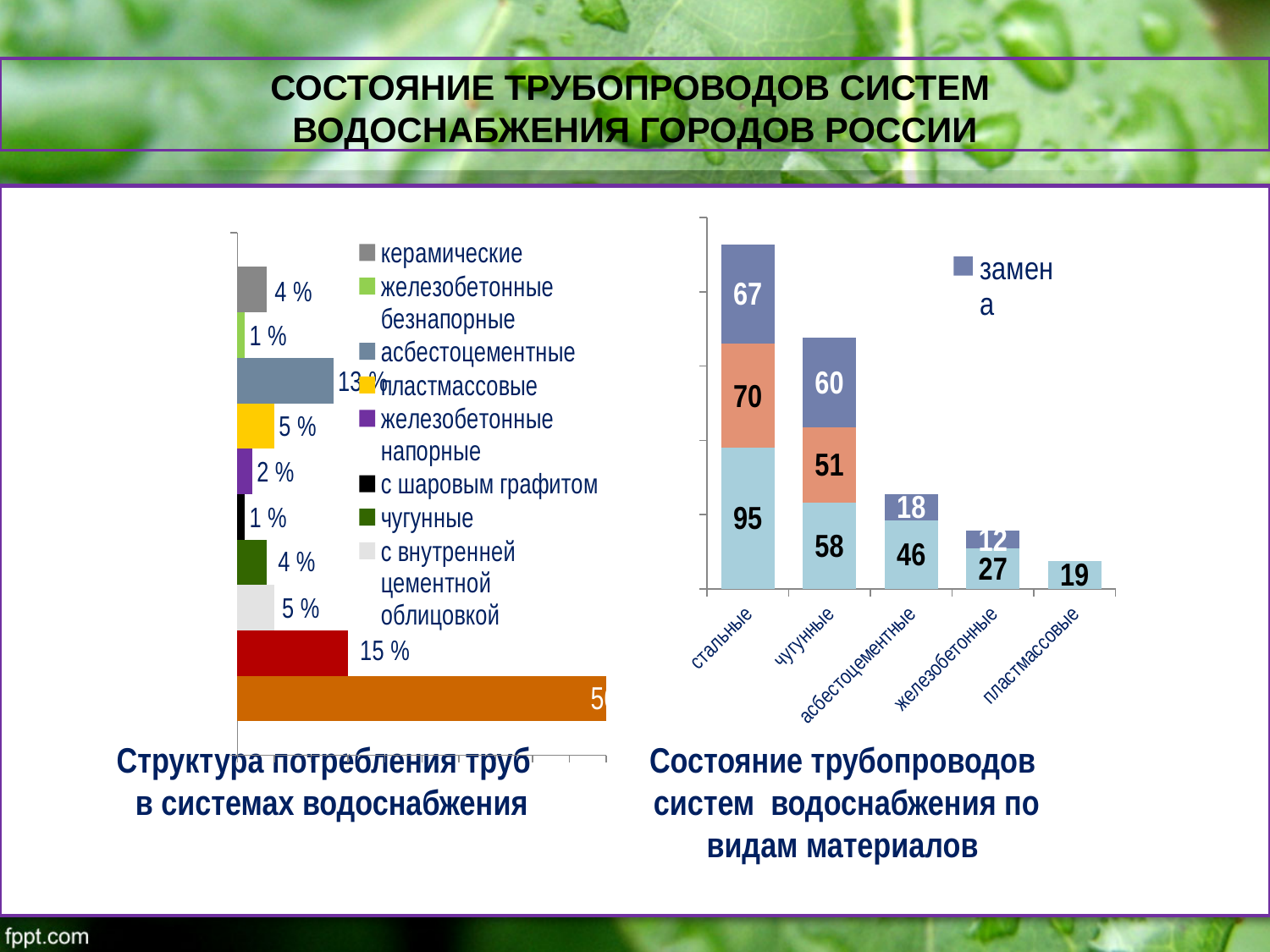
In the right chart 'Состояние трубопроводов систем водоснабжения по видам материалов', what is the value of the bottom segment for стальные? 95 How many categories are shown on the x axis of the right chart 'Состояние трубопроводов систем водоснабжения по видам материалов'? 5 In the right chart 'Состояние трубопроводов систем водоснабжения по видам материалов', what is the value of the top segment (замена) for чугунные? 60 In the right chart 'Состояние трубопроводов систем водоснабжения по видам материалов', what is the total of the stacked bar for чугунные? 169 In the left chart 'Структура потребления труб в системах водоснабжения', which is larger: асбестоцементные or пластмассовые? асбестоцементные In the left chart 'Структура потребления труб в системах водоснабжения', what is the value for керамические? 4 % In the left chart 'Структура потребления труб в системах водоснабжения', what is the difference between асбестоцементные and пластмассовые? 8 % In the left chart 'Структура потребления труб в системах водоснабжения', what is the value for асбестоцементные? 13 % What kind of chart is the left chart, 'Структура потребления труб в системах водоснабжения'? bar chart In the left chart 'Структура потребления труб в системах водоснабжения', what is the value for пластмассовые? 5 % In the right chart 'Состояние трубопроводов систем водоснабжения по видам материалов', which category has the tallest stacked bar? стальные In the right chart 'Состояние трубопроводов систем водоснабжения по видам материалов', what is the total of the stacked bar for стальные? 232